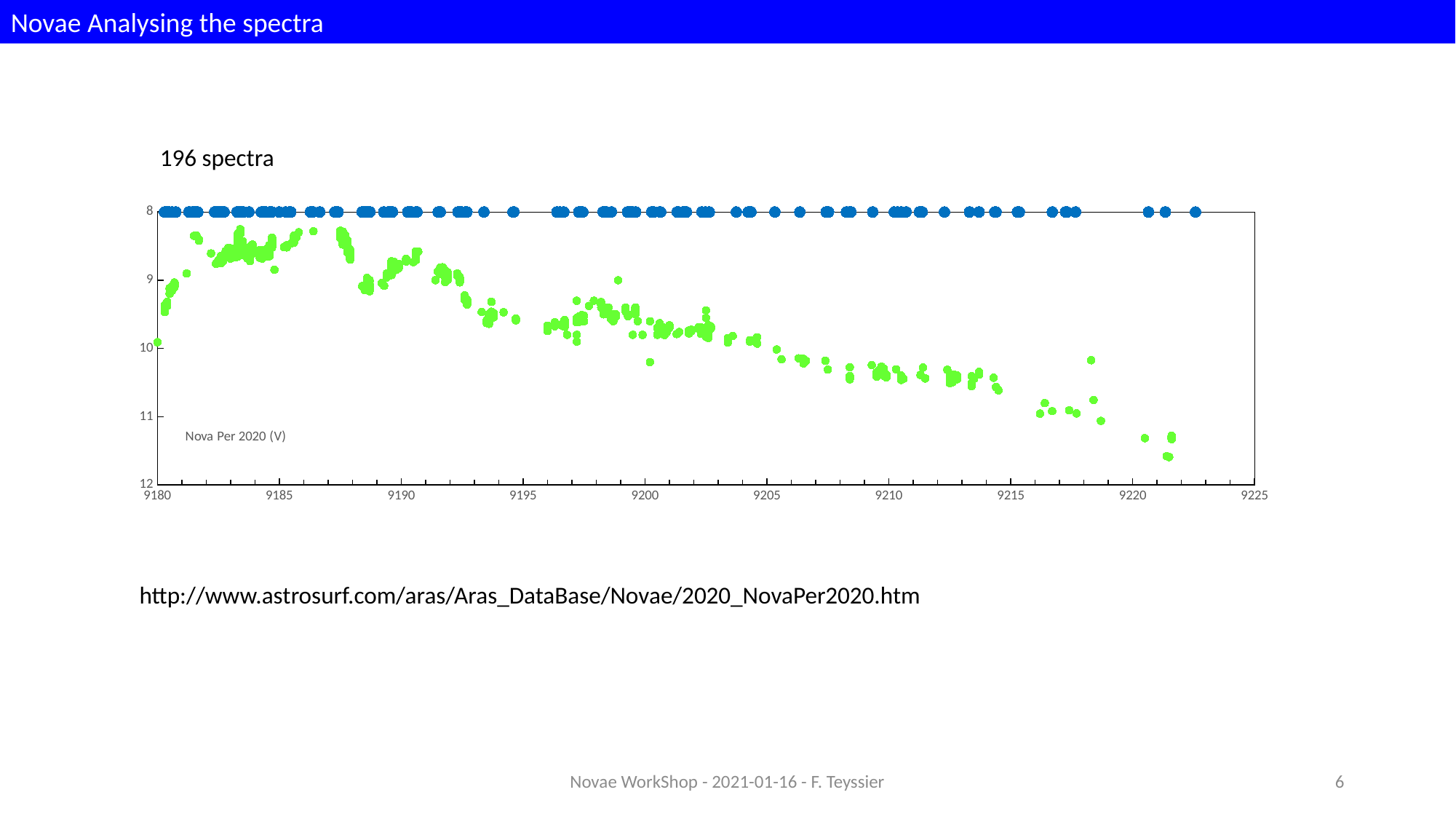
Do the magnitude values of the green points increase or decrease from left to right along the x axis? increase What is the largest value shown on the y axis of the chart? 12 Is the value of the green points near x = 9200 greater or less than 9? greater Is the value of the green points near x = 9210 greater or less than 10? greater What kind of chart is shown on the slide? scatter chart Is the value of the green points near x = 9221 greater or less than 11? greater How many spectra does the text above the chart say there are? 196 spectra At what y-axis value are all the blue points plotted? 8 What is the lowest value shown on the x axis of the chart? 9180 What label is printed inside the plot area of the chart? Nova Per 2020 (V) What is the highest value shown on the x axis of the chart? 9225